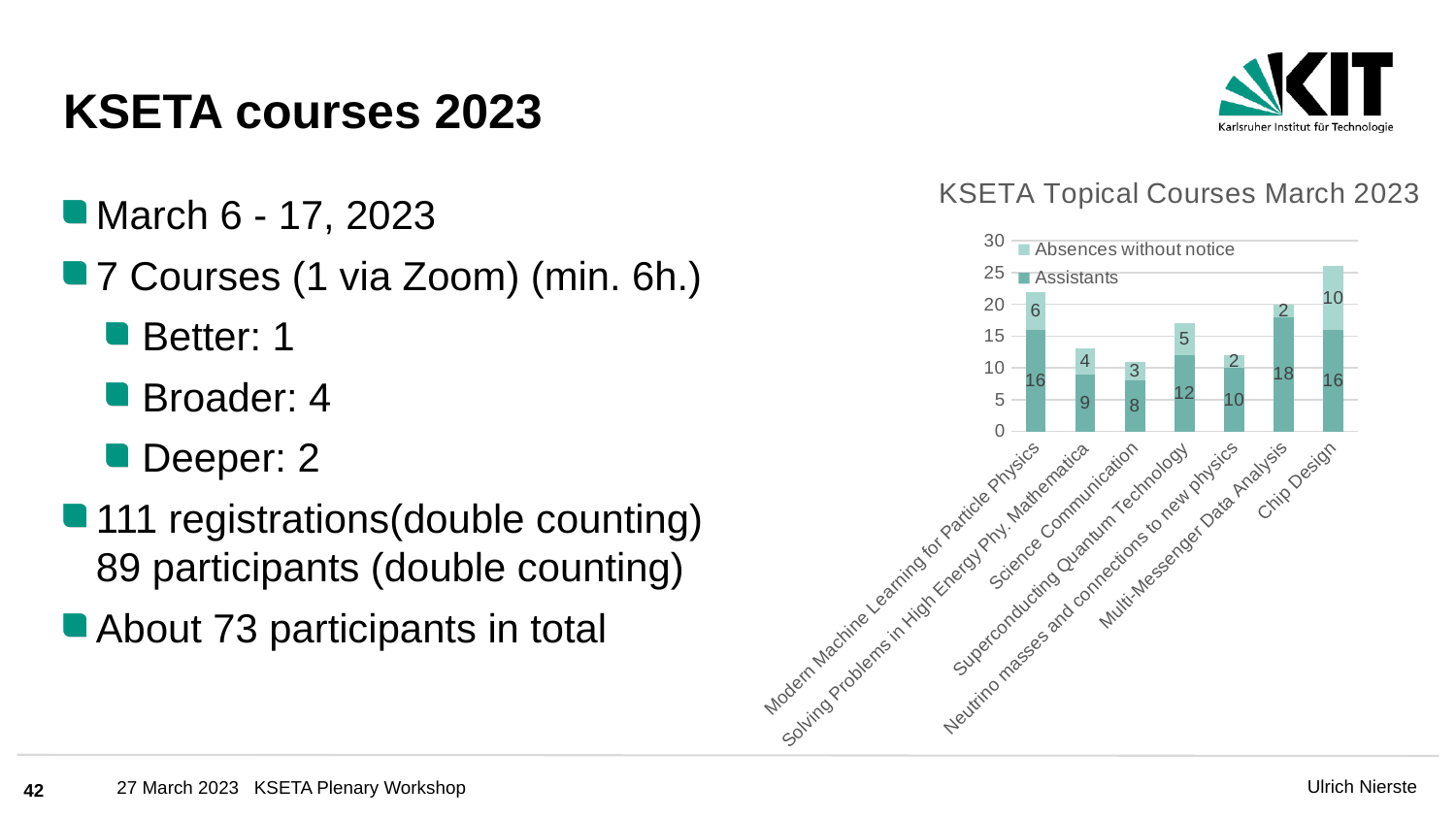
What type of chart is shown on the slide? stacked bar chart Which has a larger Assistants value, Solving Problems in High Energy Phy. Mathematica or Neutrino masses and connections to new physics? Neutrino masses and connections to new physics How many courses (categories) are shown on the x axis of the chart? 7 What is the title of the chart? KSETA Topical Courses March 2023 What is the Absences without notice value for Chip Design? 10 Which course has the lowest Assistants value? Science Communication What is the total height of the stacked bar for Modern Machine Learning for Particle Physics? 22 What is the Assistants value for Science Communication? 8 What is the difference between the Assistants values for Multi-Messenger Data Analysis and Superconducting Quantum Technology? 6 Which course has the highest Absences without notice value? Chip Design How many series does the chart legend list? 2 What is the Assistants value for Multi-Messenger Data Analysis? 18